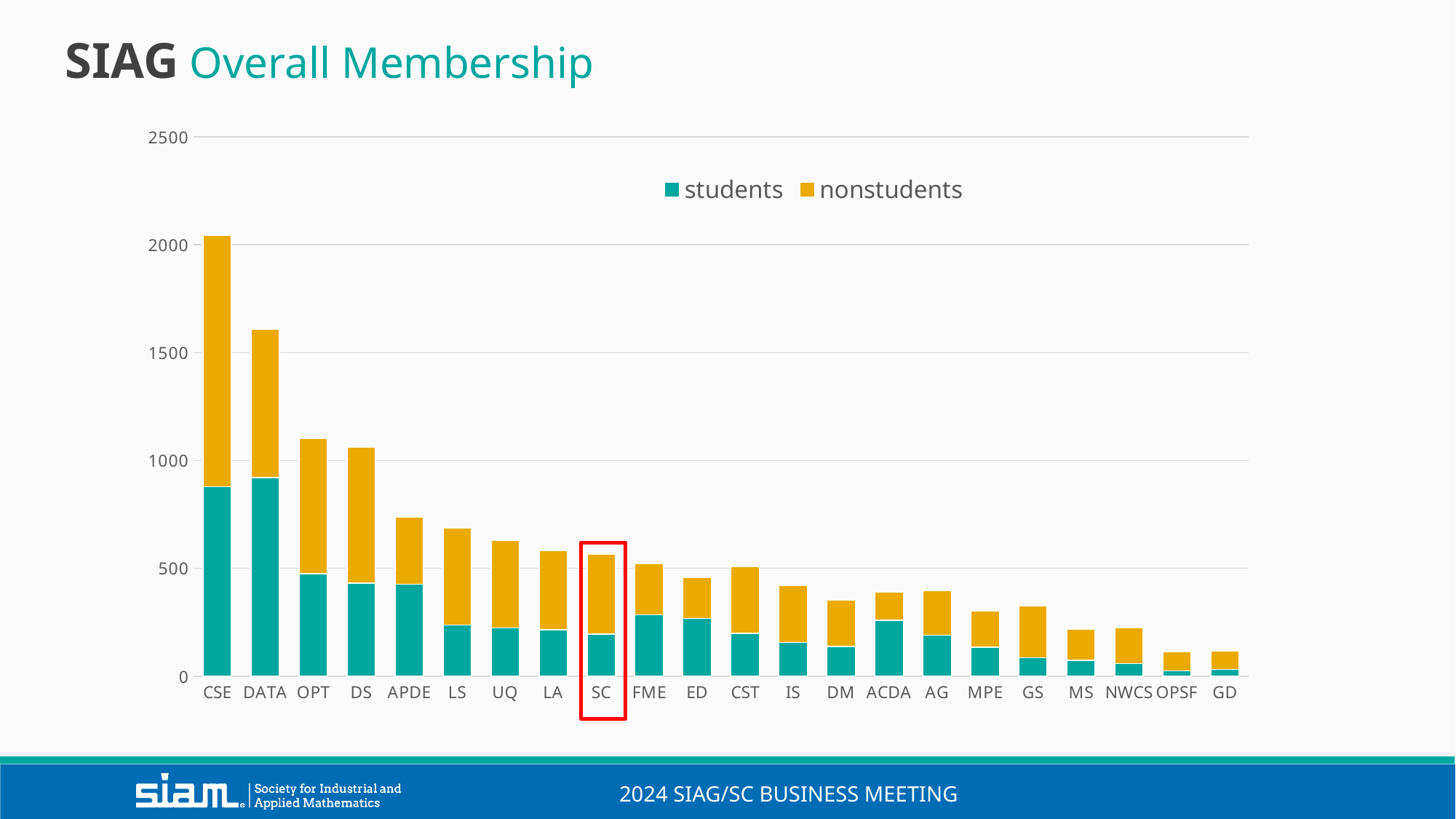
Is the total membership for OPT greater or less than 1000? greater How many series does the legend list? 2 Which SIAG has the highest overall membership? CSE Do the total membership values generally rise or fall from left to right along the x axis? fall Is the number of students for CSE greater or less than 1000? less Is the total membership for SC greater or less than 500? greater What kind of chart is shown on the slide? stacked bar chart Which SIAG category is highlighted with a red box? SC Which has a larger total membership, CSE or DATA? CSE How many SIAG categories are shown on the x axis? 22